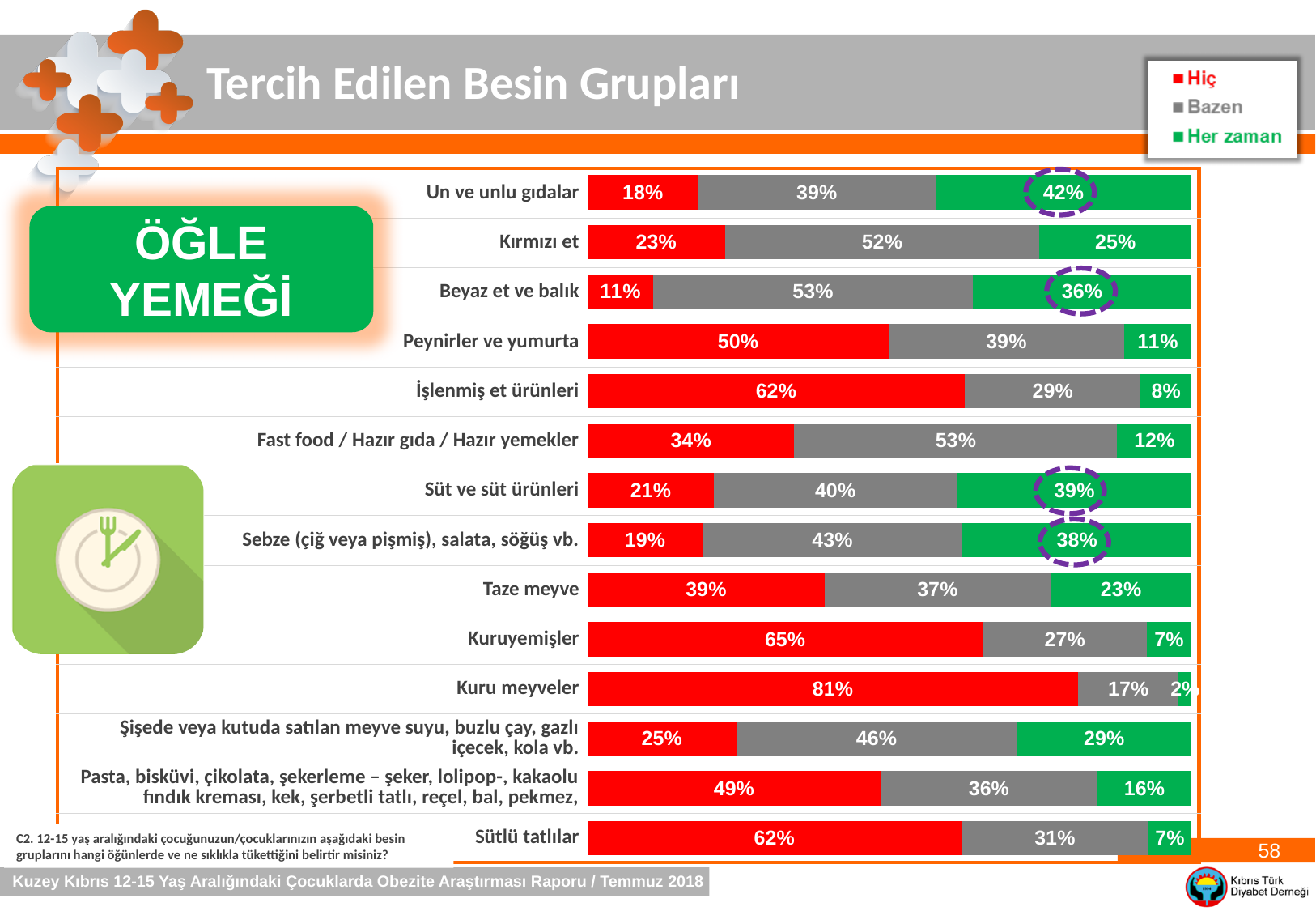
What percentage of respondents answered "Her zaman" for Un ve unlu gıdalar? 42% What is the difference between the "Hiç" values for Kuruyemişler and Taze meyve? 26% What kind of chart is shown on the slide? Stacked bar chart Which is larger: the "Her zaman" value for Süt ve süt ürünleri or for Sebze (çiğ veya pişmiş), salata, söğüş vb.? Süt ve süt ürünleri What is the "Bazen" value for Beyaz et ve balık? 53% Which colour represents "Hiç" in the legend? Red Which food group has the lowest "Her zaman" value? Kuru meyveler What is the "Hiç" value for Kuru meyveler? 81% How many food groups (categories) are shown in the chart? 14 How many series does the legend list? 3 What is the total of the three segments for the Kırmızı et bar? 100% Which food group has the highest "Hiç" value? Kuru meyveler